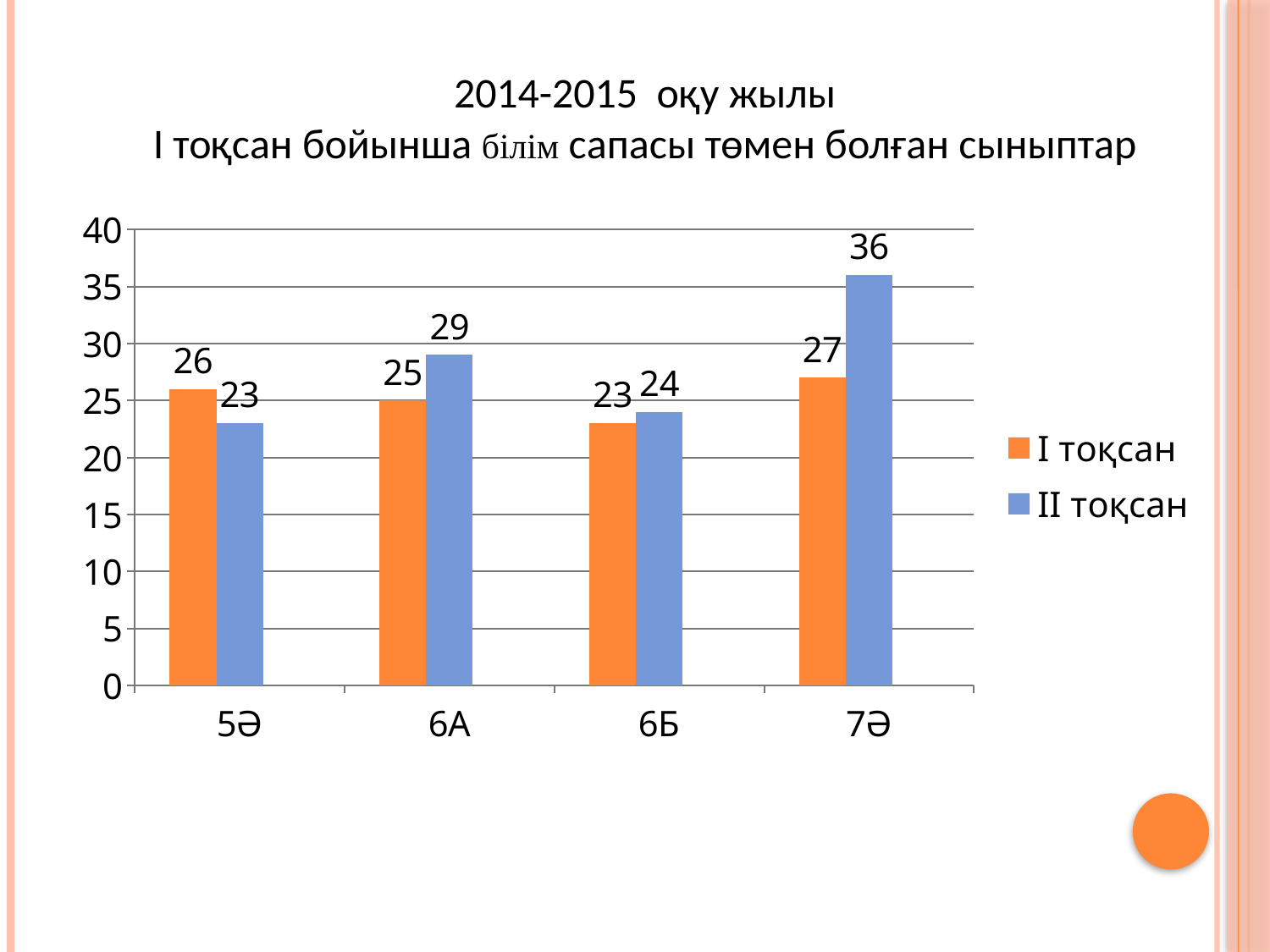
Which is larger for 5Ә: the I тоқсан value or the II тоқсан value? I тоқсан Which colour represents the II тоқсан series? blue What is the difference between the II тоқсан and I тоқсан values for 7Ә? 9 What is the value for 5Ә in the I тоқсан series? 26 What is the value for 7Ә in the II тоқсан series? 36 What kind of chart is shown on the slide? bar chart Which category has the highest value in the II тоқсан series? 7Ә Which category has the lowest value in the I тоқсан series? 6Б How many categories are shown on the x axis? 4 How many series does the legend list? 2 What is the value for 6Б in the I тоқсан series? 23 Is the value for 7Ә in the II тоқсан series greater or less than 30? greater